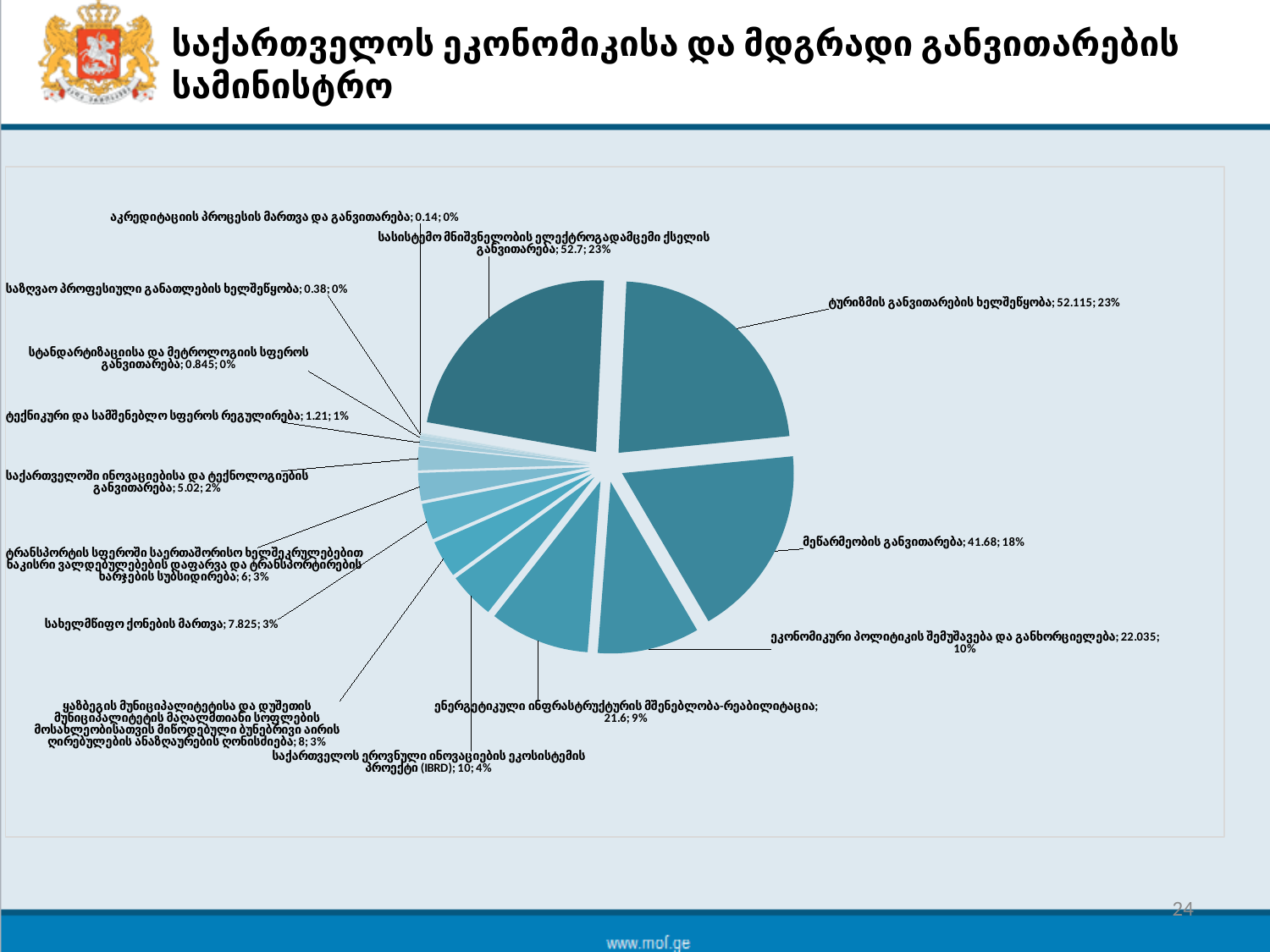
Which category has the smallest value in the pie chart? აკრედიტაციის პროცესის მართვა და განვითარება What is the difference between the values for მეწარმეობის განვითარება and ეკონომიკური პოლიტიკის შემუშავება და განხორციელება? 19.645 What is the value shown for მეწარმეობის განვითარება? 41.68 Which is larger: the value for საქართველოს ეროვნული ინოვაციების ეკოსისტემის პროექტი (IBRD) or the value for სახელმწიფო ქონების მართვა? საქართველოს ეროვნული ინოვაციების ეკოსისტემის პროექტი (IBRD) What is the value shown for ტურიზმის განვითარების ხელშეწყობა? 52.115 How many slices does the pie chart have? 14 What is the value shown for ეკონომიკური პოლიტიკის შემუშავება და განხორციელება? 22.035 What share of the pie does ენერგეტიკული ინფრასტრუქტურის მშენებლობა-რეაბილიტაცია represent? 9% Which category has the largest value in the pie chart? სასისტემო მნიშვნელობის ელექტროგადამცემი ქსელის განვითარება What kind of chart is shown on the slide? pie chart What is the value shown for სახელმწიფო ქონების მართვა? 7.825 What share of the pie does სასისტემო მნიშვნელობის ელექტროგადამცემი ქსელის განვითარება represent? 23%